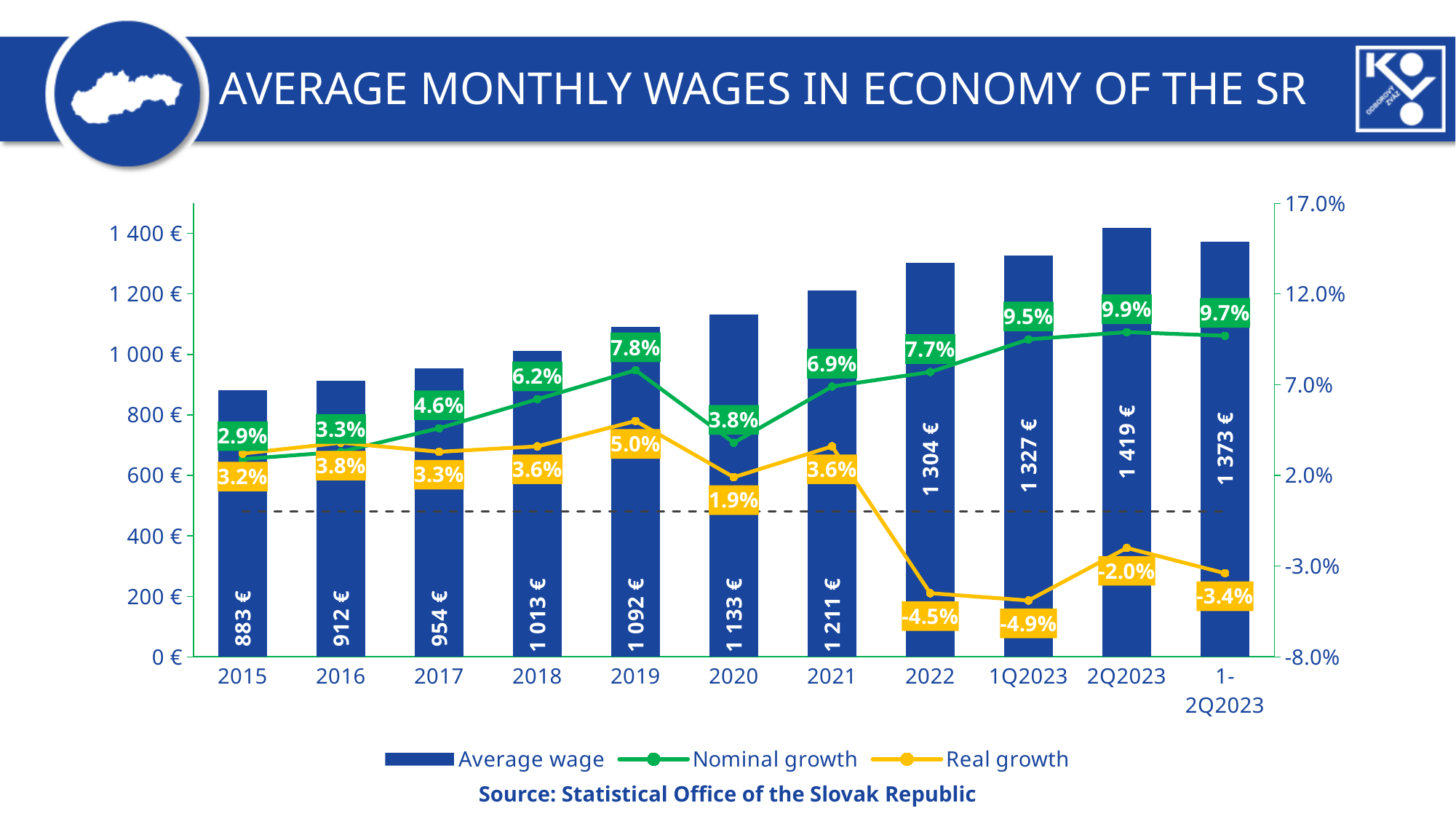
What colour is the Real growth line? Yellow What kind of chart is used for the Average wage series? Bar chart How many series does the legend list? 3 Does the average wage rise or fall from 2015 to 2022? Rise What was the nominal growth in 2Q2023? 9.9% How many periods are shown on the x axis? 11 What was the real growth in 1Q2023? -4.9% What was the average wage in 2019? 1 092 € Which period has the lowest real growth? 1Q2023 Which period has the highest average wage? 2Q2023 What is the difference between the average wage in 2022 and in 2021? 93 € Which is larger, the nominal growth in 2019 or in 2021? 2019